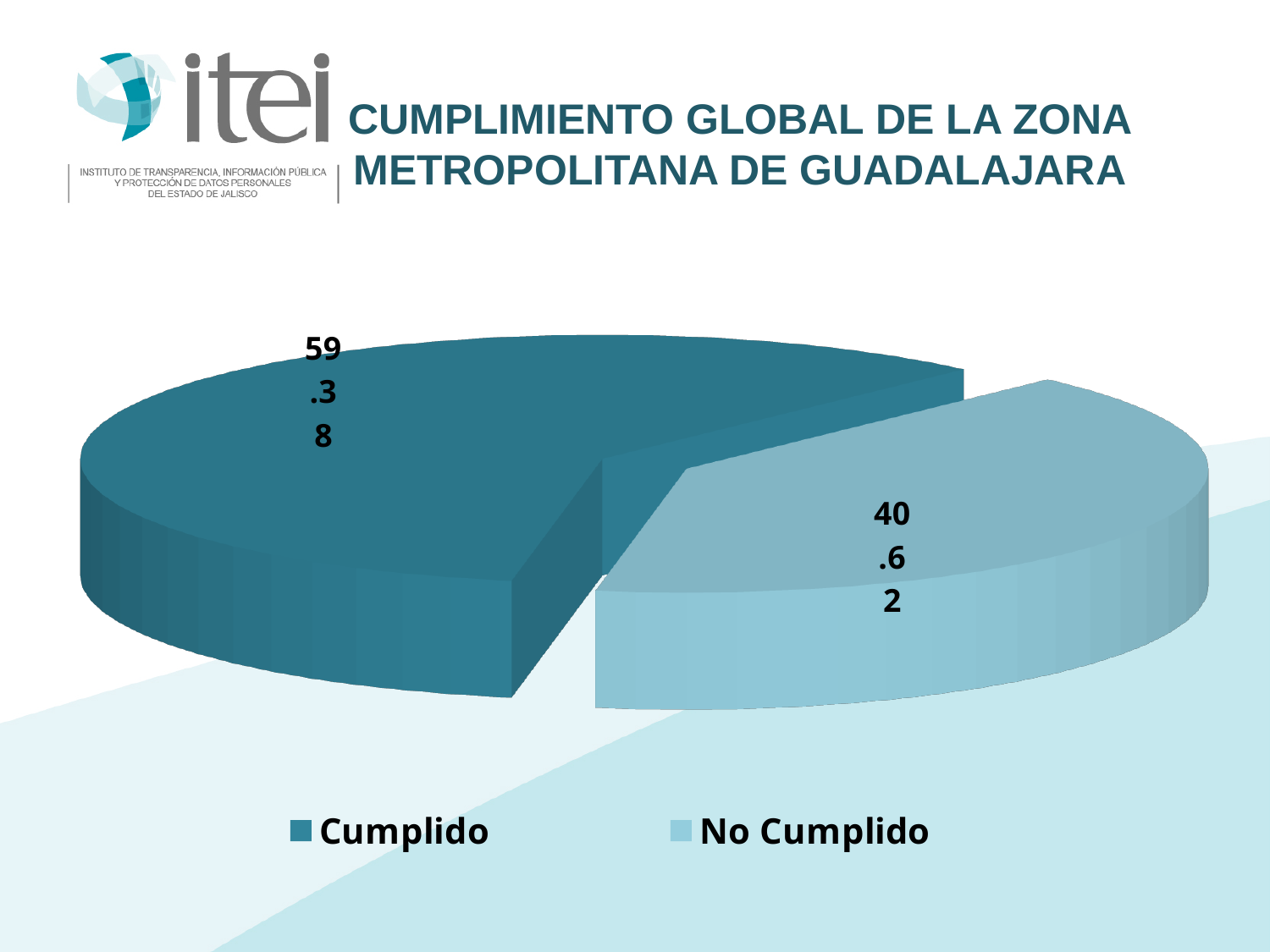
What is the total of the two slice values? 100 What is the value shown for the Cumplido slice? 59.38 What is the title of the slide containing the chart? CUMPLIMIENTO GLOBAL DE LA ZONA METROPOLITANA DE GUADALAJARA Which slice is the largest? Cumplido Which slice is the smallest? No Cumplido How many entries does the legend list? 2 What kind of chart is shown on the slide? Pie chart Which legend entry is shown in the lighter blue colour? No Cumplido What is the value shown for the No Cumplido slice? 40.62 Which is larger, Cumplido or No Cumplido? Cumplido What is the difference between the Cumplido and No Cumplido values? 18.76 How many slices does the pie chart have? 2